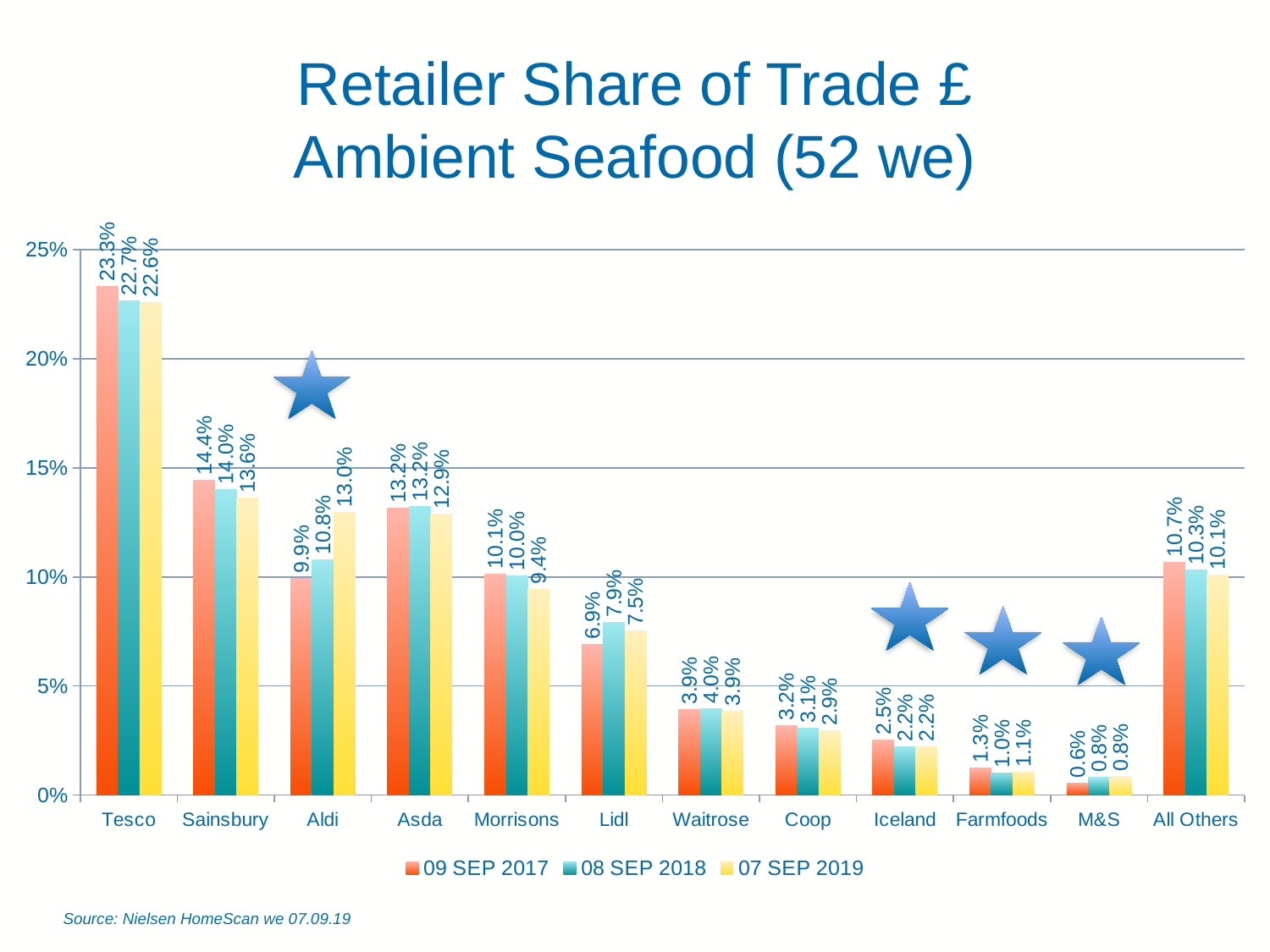
Which retailer has the lowest share of trade in the 09 SEP 2017 series? M&S How many retailer categories are shown on the x axis? 12 Is the value for Morrisons in 09 SEP 2017 greater or less than 10%? greater What is the difference between Aldi's 07 SEP 2019 value and its 09 SEP 2017 value? 3.1% Does Lidl's share of trade rise or fall from 09 SEP 2017 to 08 SEP 2018? Rise What is Tesco's share of trade for 07 SEP 2019? 22.6% What is Aldi's share of trade for 09 SEP 2017? 9.9% What kind of chart is shown on the slide? Bar chart Which retailer has the highest share of trade in the 07 SEP 2019 series? Tesco How many series does the legend list? 3 Which is larger for 07 SEP 2019: Sainsbury or Asda? Sainsbury What is the value for Lidl in the 08 SEP 2018 series? 7.9%